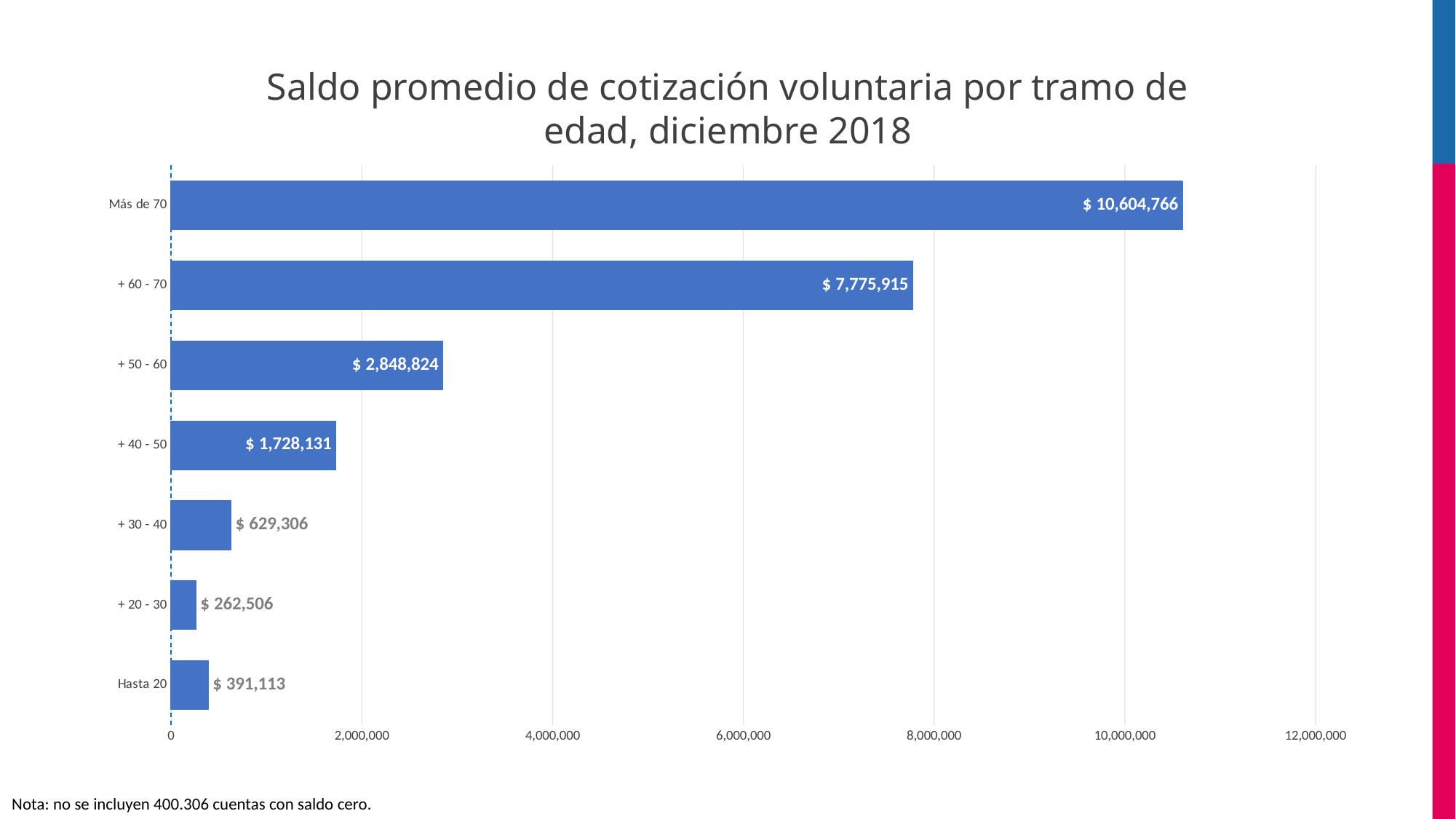
How many age groups are shown in the chart? 7 What is the difference between the values for 'Hasta 20' and '+ 20 - 30'? $ 128,607 What is the value for the 'Hasta 20' age group? $ 391,113 Is the value for '+ 60 - 70' greater or less than 8,000,000? less Which age group has the highest average voluntary contribution balance? Más de 70 What is the difference between the values for 'Más de 70' and '+ 60 - 70'? $ 2,828,851 What is the value for the '+ 40 - 50' age group? $ 1,728,131 What is the title of the chart? Saldo promedio de cotización voluntaria por tramo de edad, diciembre 2018 Which age group has the lowest average voluntary contribution balance? + 20 - 30 What kind of chart is shown on the slide? bar chart What is the value for the 'Más de 70' age group? $ 10,604,766 Which is larger, the value for 'Hasta 20' or the value for '+ 20 - 30'? Hasta 20